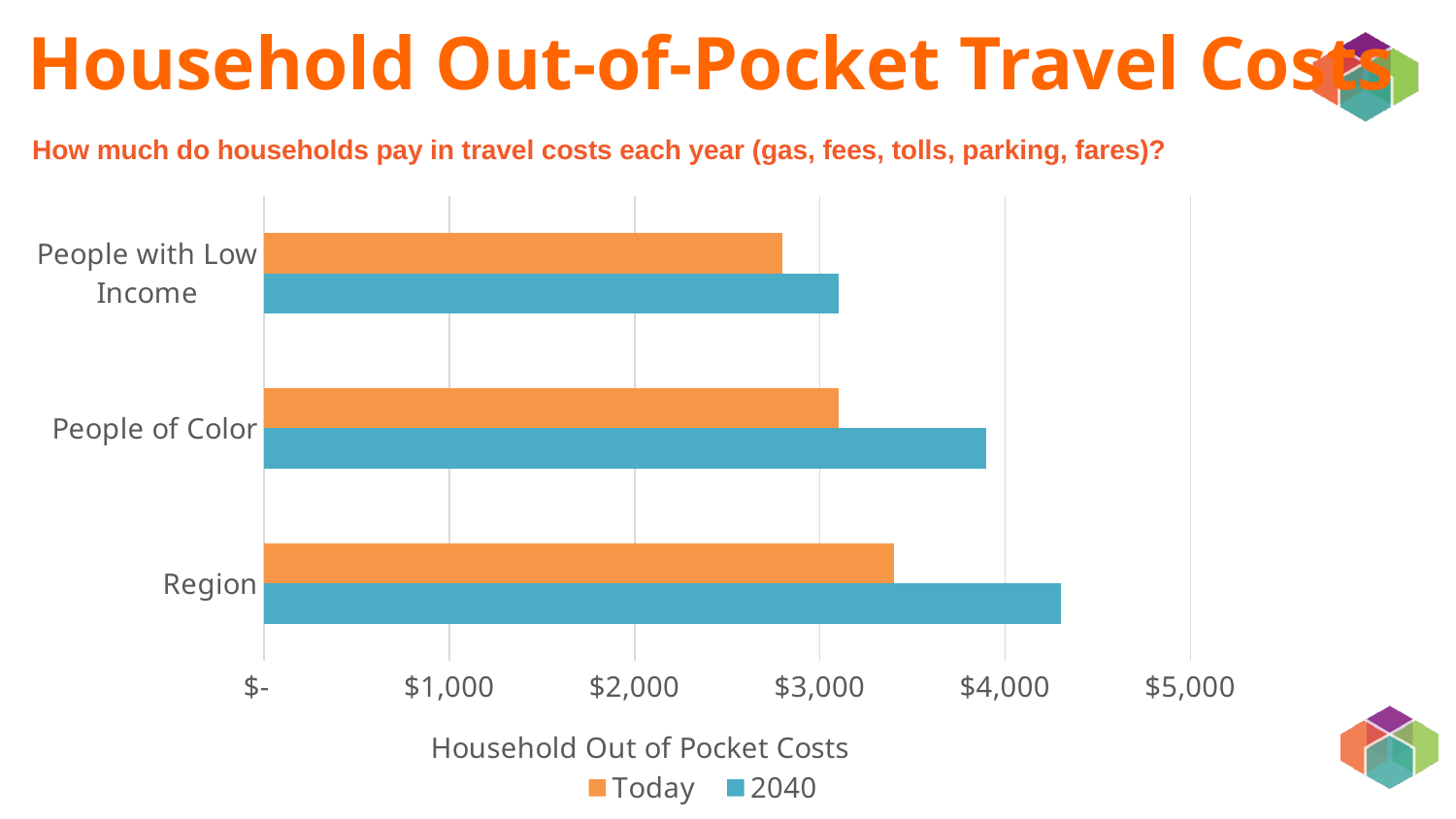
Is the 2040 value for People with Low Income greater or less than $4,000? less Is the Today value for People with Low Income greater or less than $3,000? less Which category has the highest 2040 value? Region What is the title of the horizontal axis? Household Out of Pocket Costs How many series does the legend list? 2 What kind of chart is shown on the slide? bar chart Is the Today value for Region greater or less than $3,000? greater Which is larger, the Today value for Region or the Today value for People with Low Income? Region How many categories are shown on the chart? 3 For each category, is the 2040 value higher or lower than the Today value? higher Which category has the lowest Today value? People with Low Income